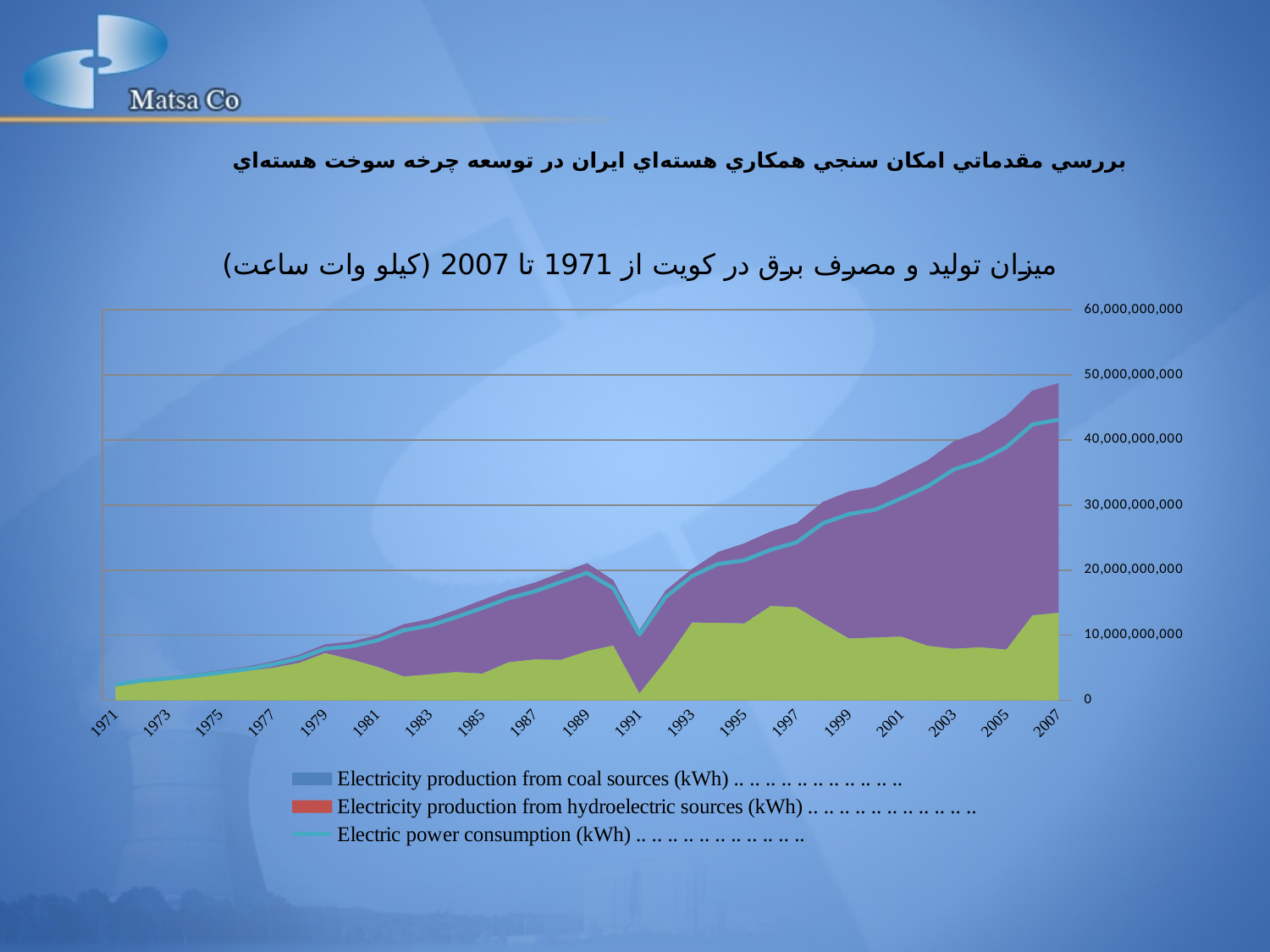
Is the Electric power consumption (kWh) value for 1971 greater or less than 10,000,000,000? less Which year has the highest Electric power consumption (kWh) value? 2007 How many series does the legend list? 3 Does the Electric power consumption (kWh) line rise or fall overall from 1971 to 2007? rise Does the Electric power consumption (kWh) line rise or fall between 1989 and 1991? fall What is the last year shown on the x axis? 2007 What is the highest value shown on the y axis? 60,000,000,000 What is the first year shown on the x axis? 1971 Is the Electric power consumption (kWh) value for 2007 greater or less than 40,000,000,000? greater What kind of chart is shown on the slide? combination area and line chart Is the Electric power consumption (kWh) value for 1999 greater or less than 20,000,000,000? greater